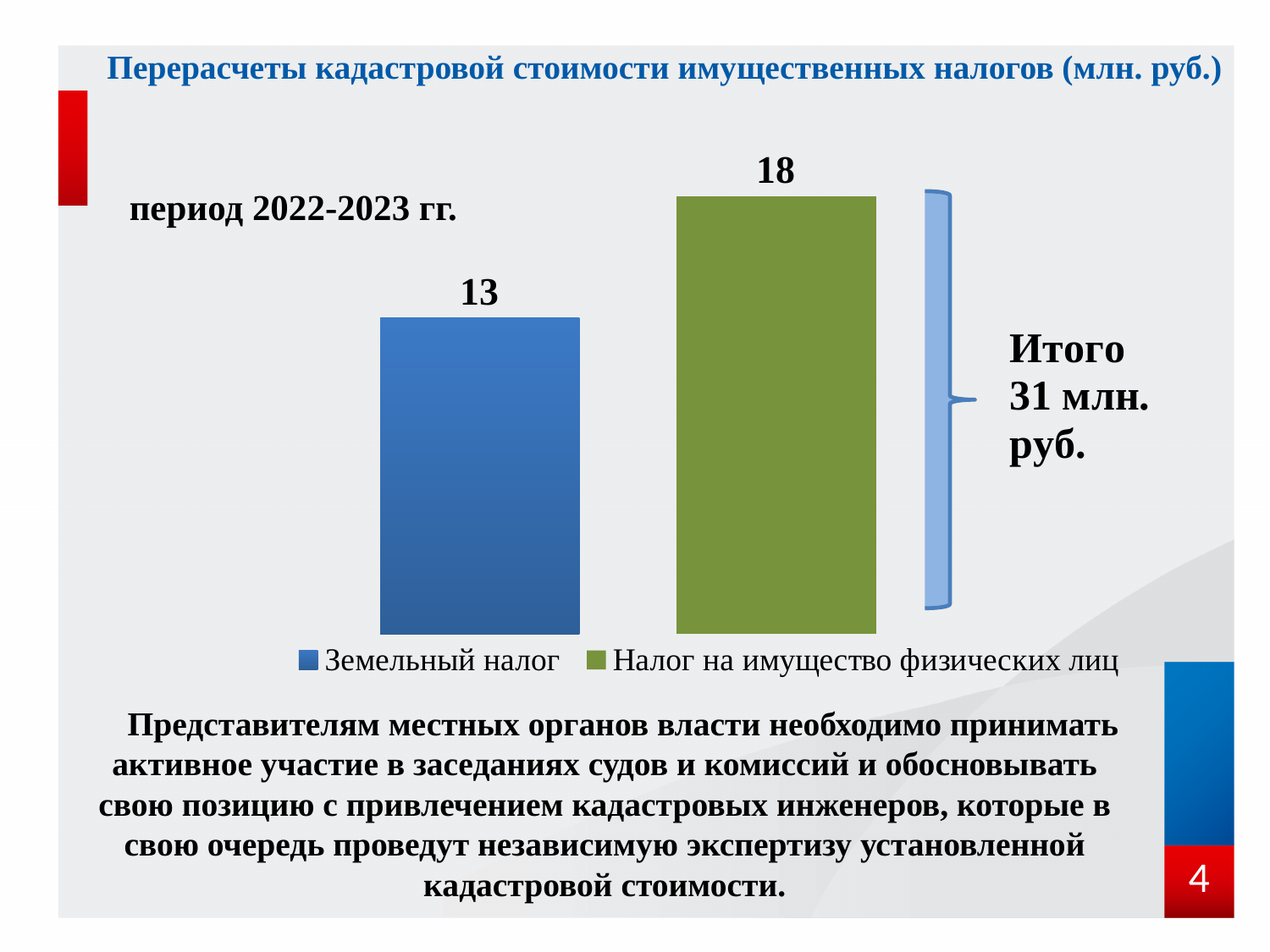
What is the value for Налог на имущество физических лиц? 18 How many bars are plotted on the chart? 2 What is the difference between the values for Налог на имущество физических лиц and Земельный налог? 5 Which is larger: Земельный налог or Налог на имущество физических лиц? Налог на имущество физических лиц What is the title of the chart? Перерасчеты кадастровой стоимости имущественных налогов (млн. руб.) Which series has the highest value? Налог на имущество физических лиц What is the value for Земельный налог? 13 What kind of chart is shown on the slide? bar chart How many series does the legend list? 2 What colour is the bar for Земельный налог? blue Which series has the lowest value? Земельный налог What is the total of the two bars shown on the chart? 31